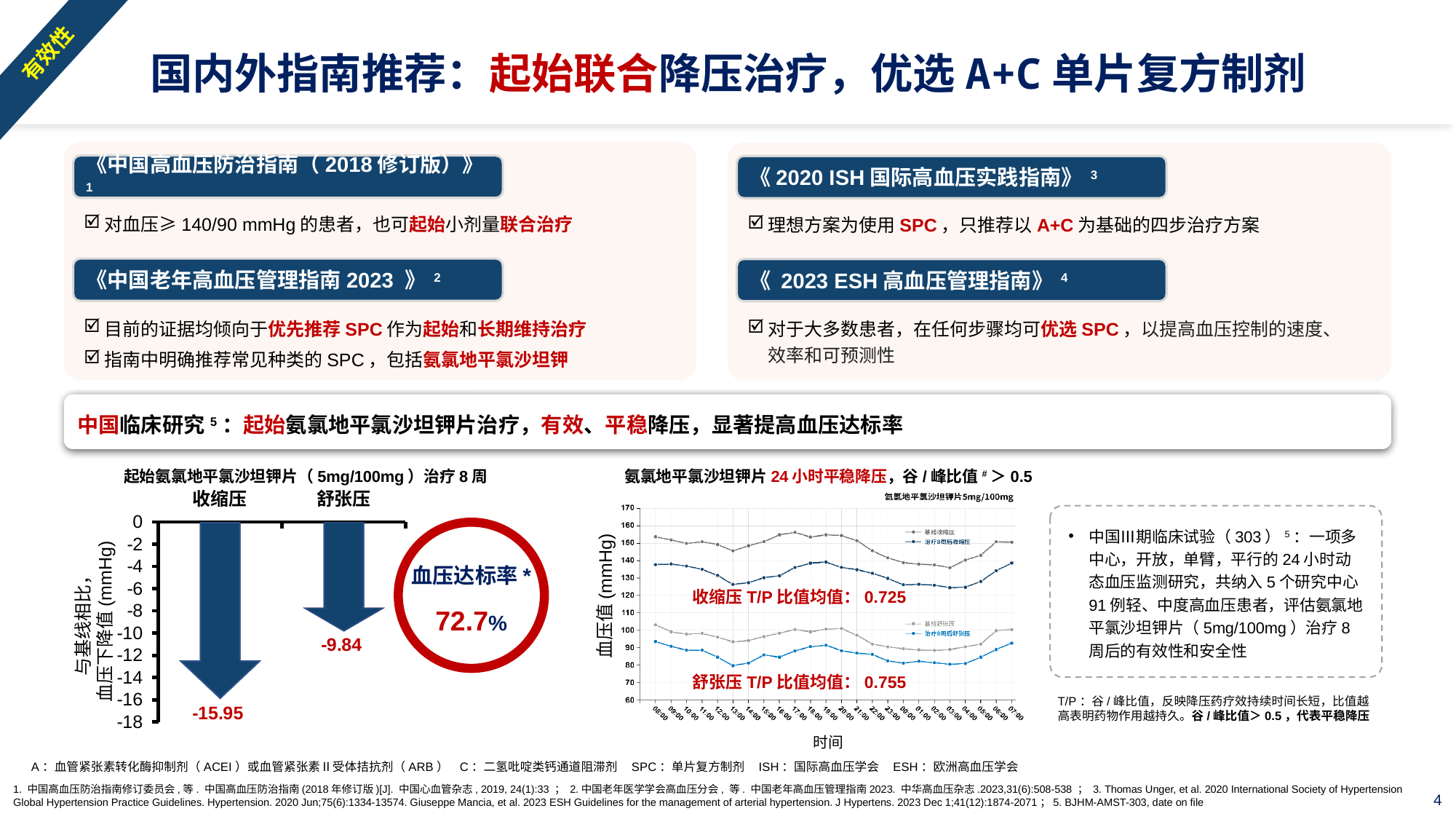
In the left bar chart (起始氨氯地平氯沙坦钾片治疗8周), what is the reduction from baseline for 收缩压? -15.95 How many categories are plotted in the left bar chart? 2 In the right line chart, is the 基线收缩压 value at 17:00 greater or less than 150? greater In the left bar chart, which category shows the larger reduction from baseline, 收缩压 or 舒张压? 收缩压 In the left bar chart, what is the reduction from baseline for 舒张压? -9.84 What kind of chart is the left chart showing 收缩压 and 舒张压 reductions? Bar chart In the left bar chart, what is the difference between the 收缩压 and 舒张压 reductions (in mmHg)? 6.11 How many series does the legend of the right line chart (氨氯地平氯沙坦钾片5mg/100mg) list? 4 How many time points are plotted along the x axis of the right line chart? 24 What is the y-axis label of the left bar chart? 与基线相比，血压下降值 (mmHg) What kind of chart is the right chart showing 24-hour blood pressure values? Line chart In the right line chart, is the 治疗8周后舒张压 value at 13:00 greater or less than 90? less